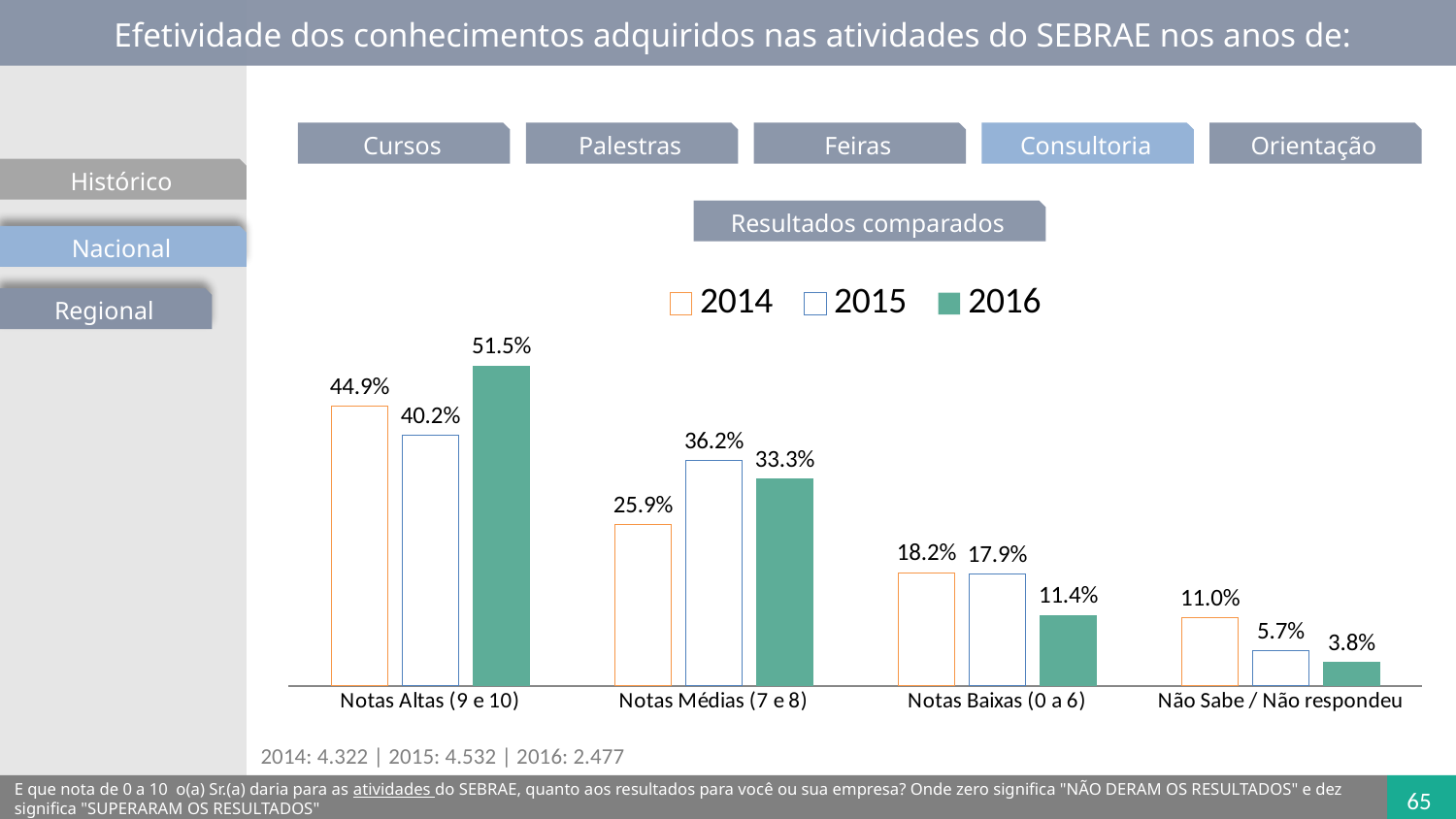
How many categories are shown on the x axis? 4 What is the difference between the 2015 and 2016 values for Notas Médias (7 e 8)? 2.9% What is the 2016 value for Notas Altas (9 e 10)? 51.5% How many series does the legend list? 3 What is the 2016 value for Não Sabe / Não respondeu? 3.8% Which category has the lowest 2014 value? Não Sabe / Não respondeu What is the difference between the 2016 and 2014 values for Notas Altas (9 e 10)? 6.6% Which category has the highest 2016 value? Notas Altas (9 e 10) What is the 2014 value for Notas Médias (7 e 8)? 25.9% What kind of chart is shown on the slide? bar chart What is the 2015 value for Notas Baixas (0 a 6)? 17.9% Which is larger for Notas Médias (7 e 8): the 2014 value or the 2015 value? 2015